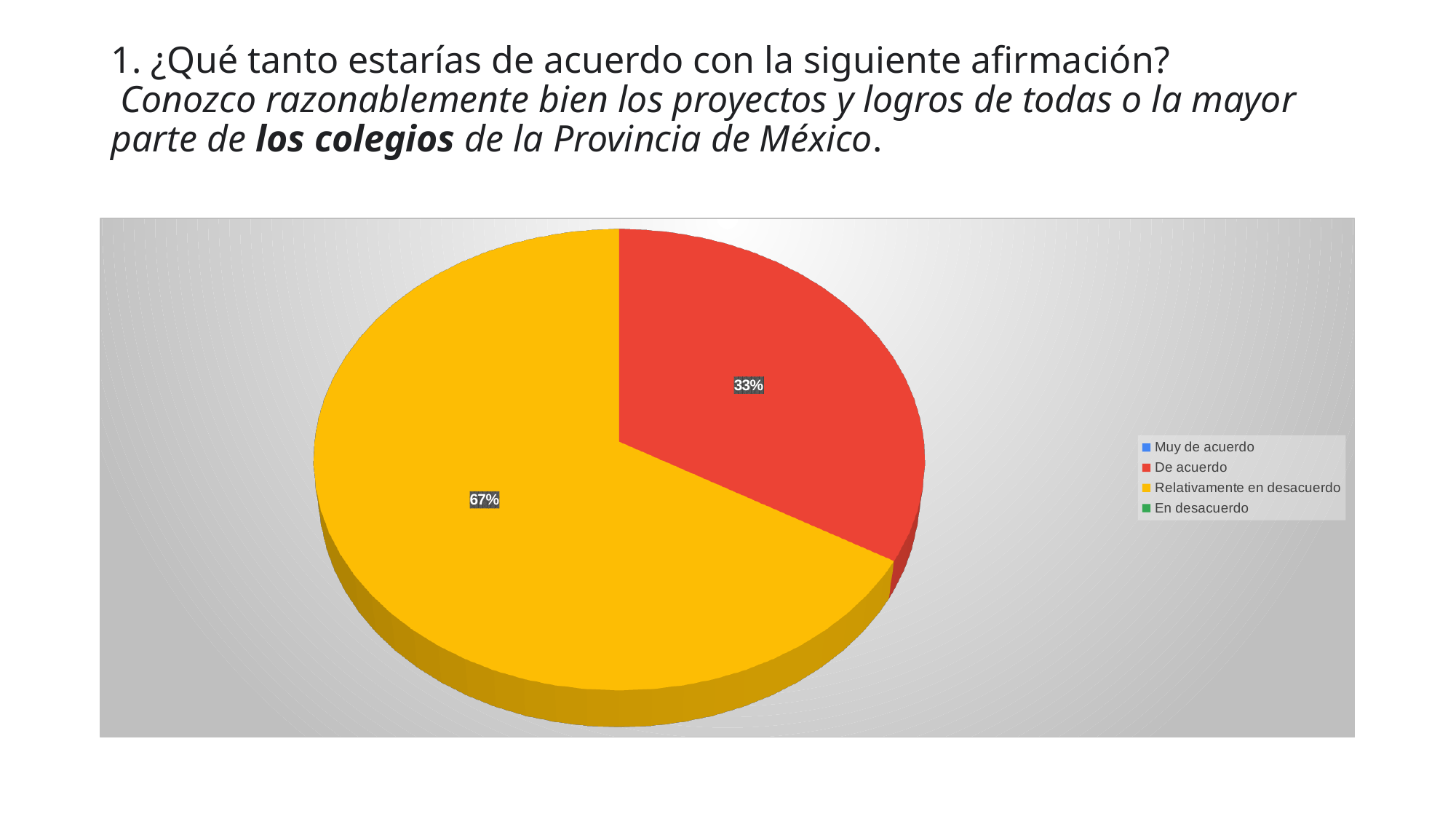
How many slices are visible in the pie? 2 Which category has the largest slice of the pie? Relativamente en desacuerdo What is the difference in percentage points between the "Relativamente en desacuerdo" slice and the "De acuerdo" slice? 34% What share of the pie does "De acuerdo" represent? 33% What colour is the "De acuerdo" slice? red Is the share for "De acuerdo" greater or less than 50%? less Which legend entry is shown in yellow? Relativamente en desacuerdo Which is larger, the slice for "De acuerdo" or the slice for "Relativamente en desacuerdo"? Relativamente en desacuerdo What kind of chart is shown on the slide? pie chart What share of the pie does "Relativamente en desacuerdo" represent? 67% How many categories does the legend list? 4